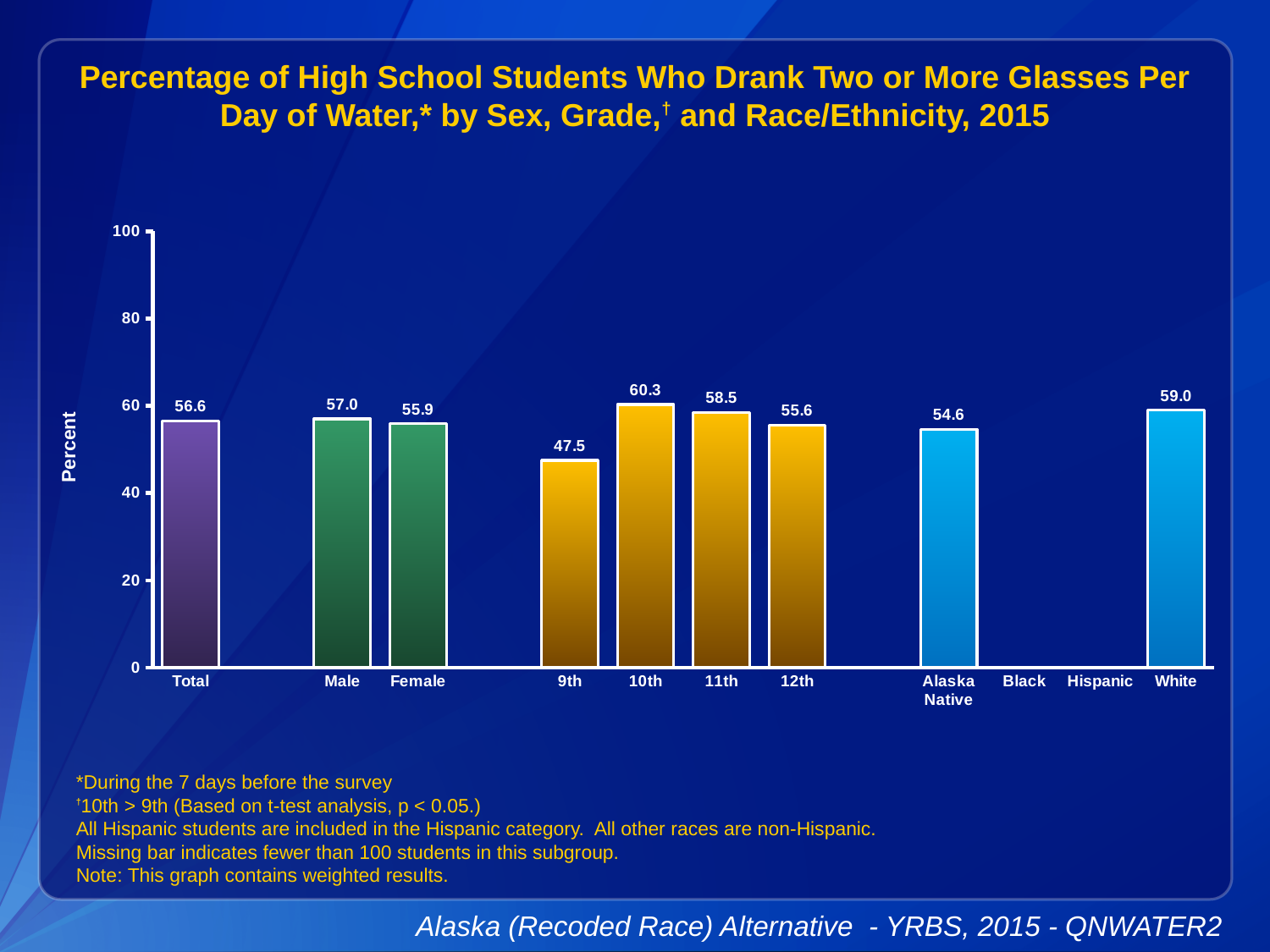
Which category with a bar has the lowest value? 9th What is the value for 9th grade students? 47.5 Which category has the highest value? 10th What is the value for Total? 56.6 What is the difference between the values for 10th and 9th grade? 12.8 Which categories have no bar shown? Black and Hispanic What is the value for Alaska Native students? 54.6 Which is larger, the value for White or the value for Alaska Native? White What is the difference between the values for Male and Female? 1.1 What kind of chart is shown? bar chart Is the value for 12th grade greater or less than 40? greater How many categories have a bar plotted? 9